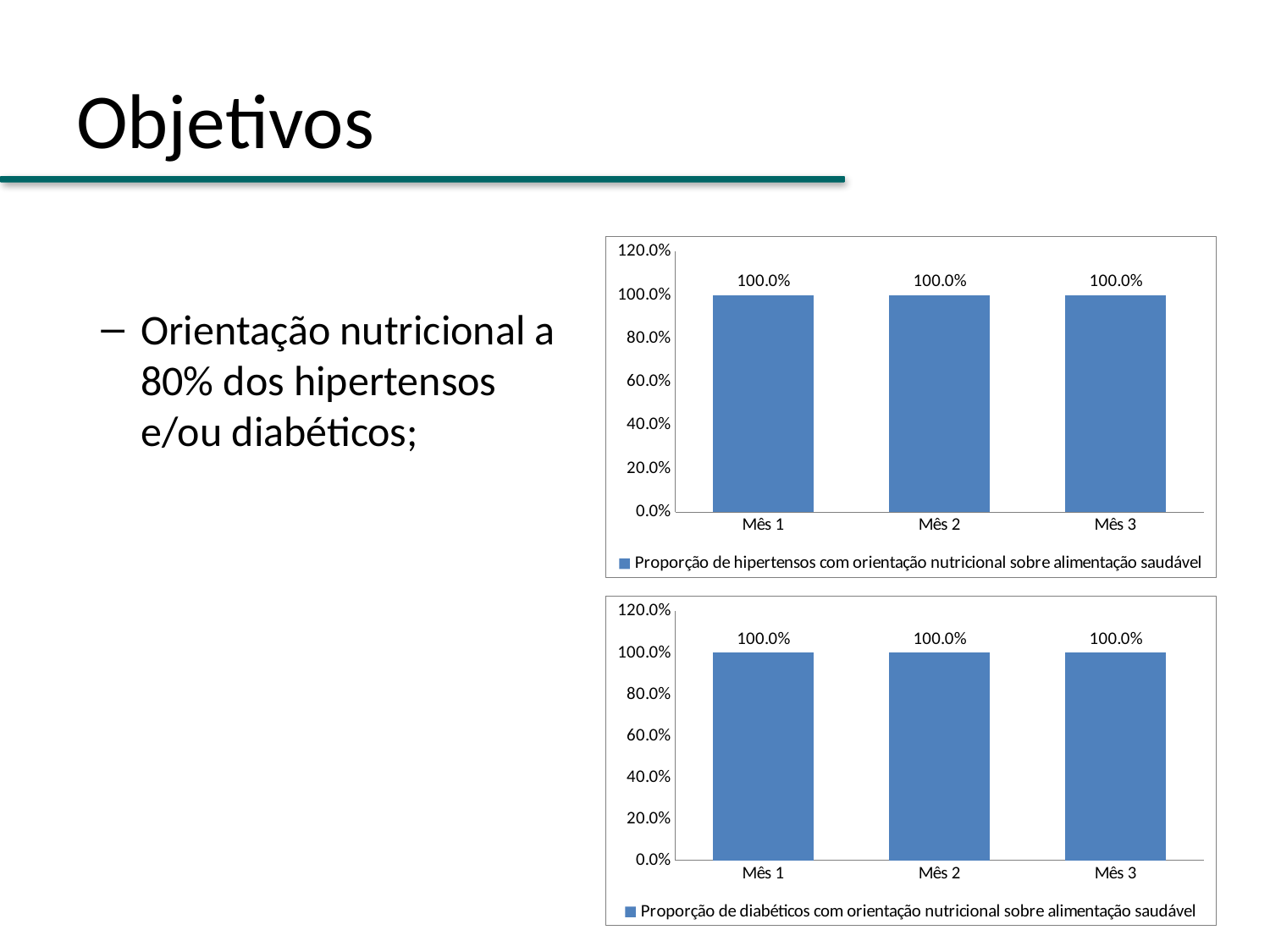
In the bottom chart (diabéticos), do the values rise, fall or stay the same from Mês 1 to Mês 3? stay the same In the bottom chart (diabéticos), what is the value for Mês 3? 100.0% How many series does the legend of the bottom chart (diabéticos) list? 1 What is the legend entry of the top chart? Proporção de hipertensos com orientação nutricional sobre alimentação saudável In the bottom chart (diabéticos), is the value for Mês 1 greater or less than 80.0%? greater How many categories are shown on the x axis of the top chart (hipertensos)? 3 In the top chart (hipertensos), what is the value for Mês 3? 100.0% In the top chart (hipertensos), what is the value for Mês 1? 100.0% In the top chart (hipertensos), what is the difference between the values for Mês 1 and Mês 2? 0.0% In the bottom chart (diabéticos), what is the value for Mês 2? 100.0% What is the highest value shown on the y axis of the bottom chart (diabéticos)? 120.0% What kind of chart is the top chart (hipertensos)? bar chart